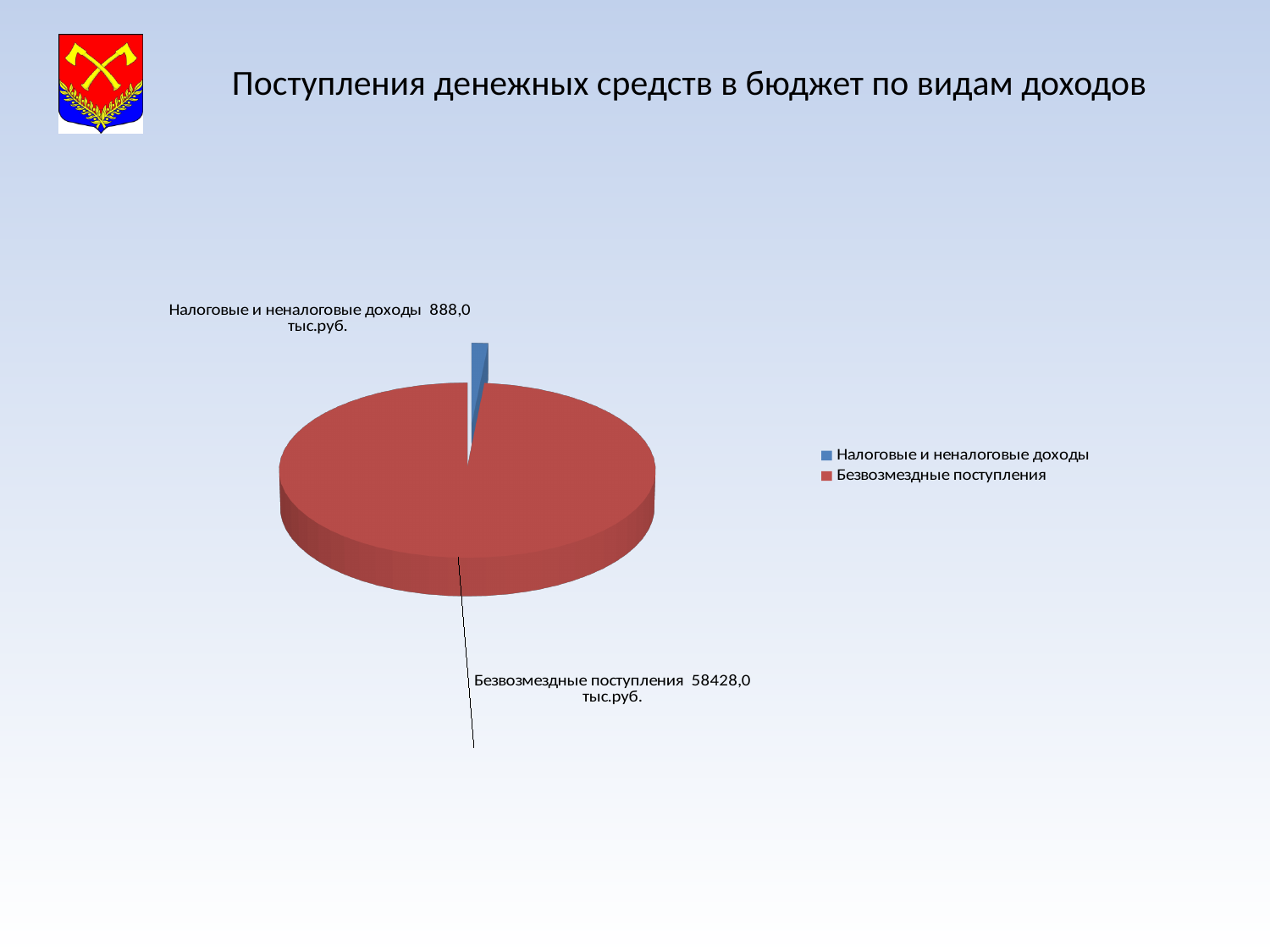
What is the title of the slide? Поступления денежных средств в бюджет по видам доходов Which is larger: Налоговые и неналоговые доходы or Безвозмездные поступления? Безвозмездные поступления How many categories does the pie chart have? 2 What colour is the slice for Безвозмездные поступления? Red What is the value for Налоговые и неналоговые доходы? 888,0 тыс.руб. Which category has the smallest slice of the pie? Налоговые и неналоговые доходы What is the difference between Безвозмездные поступления and Налоговые и неналоговые доходы? 57540,0 тыс.руб. How many entries does the legend list? 2 Which category has the largest slice of the pie? Безвозмездные поступления What kind of chart is shown on the slide? Pie chart What is the value for Безвозмездные поступления? 58428,0 тыс.руб. What is the total of the two categories shown in the pie chart? 59316,0 тыс.руб.